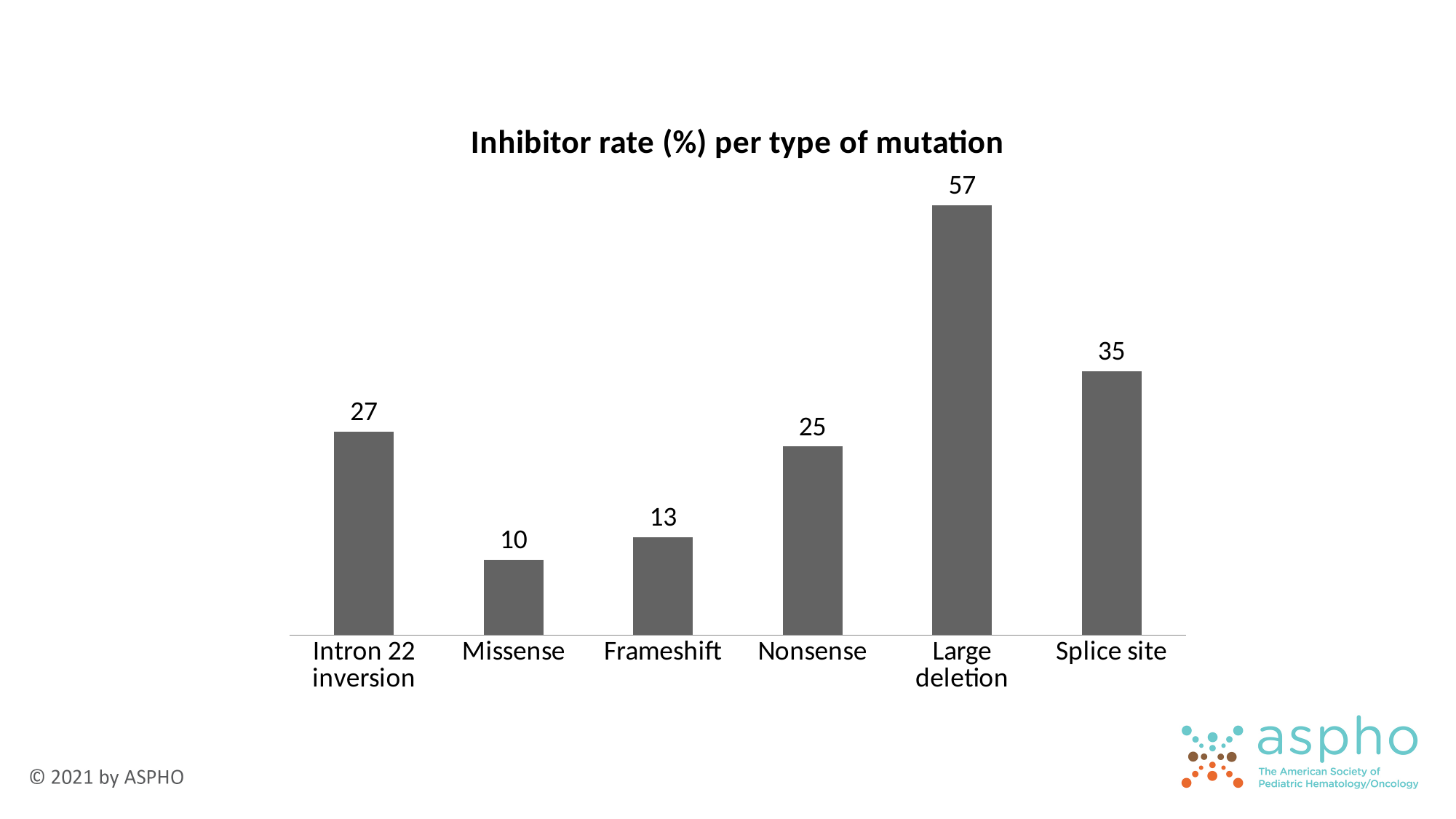
Which has a higher inhibitor rate, Frameshift or Nonsense? Nonsense What is the inhibitor rate for Missense mutations? 10 How many types of mutation are shown in the chart? 6 Which type of mutation has the lowest inhibitor rate? Missense What is the difference between the inhibitor rates for Large deletion and Splice site? 22 What is the inhibitor rate for Splice site mutations? 35 What is the inhibitor rate for Large deletion? 57 What is the inhibitor rate for Intron 22 inversion? 27 What kind of chart is shown on the slide? Bar chart What is the difference between the inhibitor rates for Intron 22 inversion and Nonsense? 2 Which type of mutation has the highest inhibitor rate? Large deletion What is the title of the chart? Inhibitor rate (%) per type of mutation